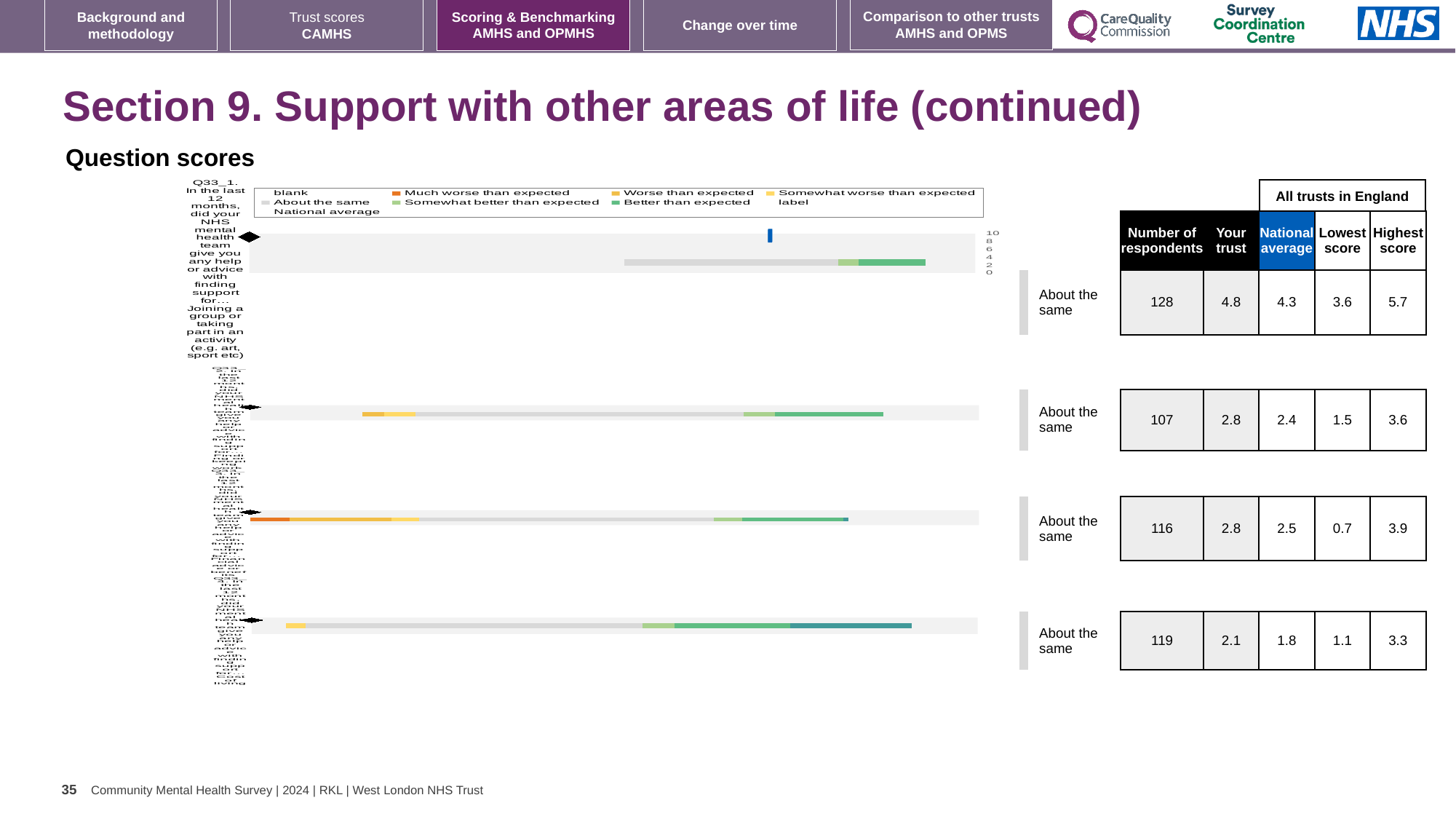
In the table beside the chart, what is the highest score for the fourth row? 3.3 What colour does the legend use for 'Much worse than expected'? orange In the table beside the chart, which row has the lowest 'Your trust' score? the fourth row, 2.1 In the table beside the chart, what is the number of respondents for the first row (Q33_1)? 128 In the table beside the chart, which row has the highest 'Your trust' score? the first row (Q33_1), 4.8 In the table beside the chart, what is the difference between the 'Your trust' score and the national average for the first row (Q33_1)? 0.5 How many horizontal bars are plotted in the chart? 4 In the table beside the chart, what is the national average for the first row (Q33_1)? 4.3 What colour does the legend use for 'Better than expected'? green What kind of chart is shown on the slide? bar chart In the table beside the chart, what is the 'Your trust' score for the first row (Q33_1)? 4.8 What benchmark label is shown next to the first bar (Q33_1)? About the same